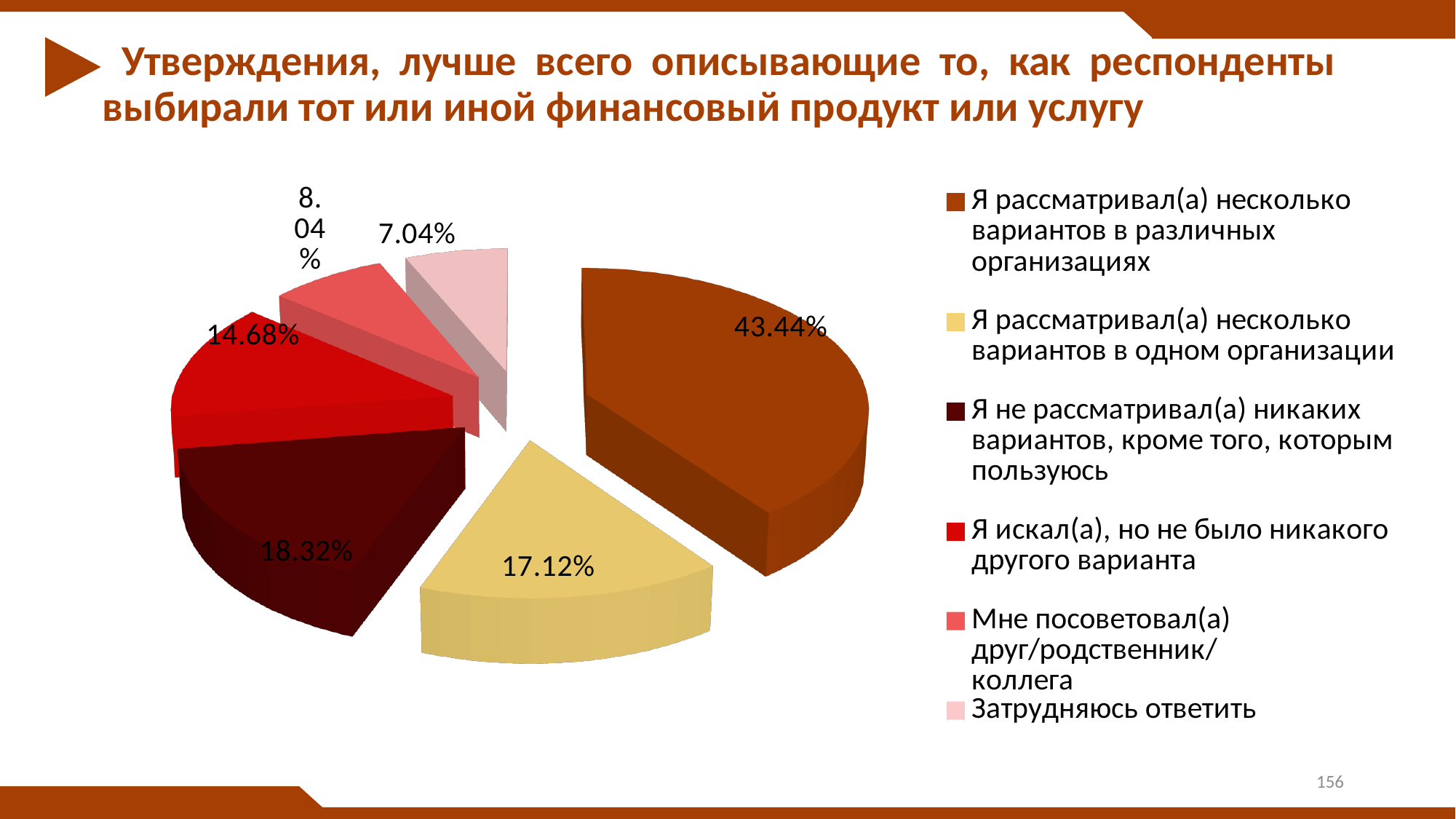
What share of respondents chose "Я не рассматривал(а) никаких вариантов, кроме того, которым пользуюсь"? 18.32% What share of respondents chose "Я рассматривал(а) несколько вариантов в различных организациях"? 43.44% Which statement has the smallest share of respondents? Затрудняюсь ответить How many slices does the pie chart have? 6 What is the difference in percentage points between "Я не рассматривал(а) никаких вариантов, кроме того, которым пользуюсь" and "Я рассматривал(а) несколько вариантов в одном организации"? 1.20 What kind of chart is shown on the slide? Pie chart What share of respondents chose "Затрудняюсь ответить"? 7.04% Which is larger: the share for "Я искал(а), но не было никакого другого варианта" or the share for "Мне посоветовал(а) друг/родственник/коллега"? Я искал(а), но не было никакого другого варианта What share of respondents chose "Я искал(а), но не было никакого другого варианта"? 14.68% What share of respondents chose "Я рассматривал(а) несколько вариантов в одном организации"? 17.12% How many entries does the legend list? 6 Which statement has the largest share of respondents? Я рассматривал(а) несколько вариантов в различных организациях